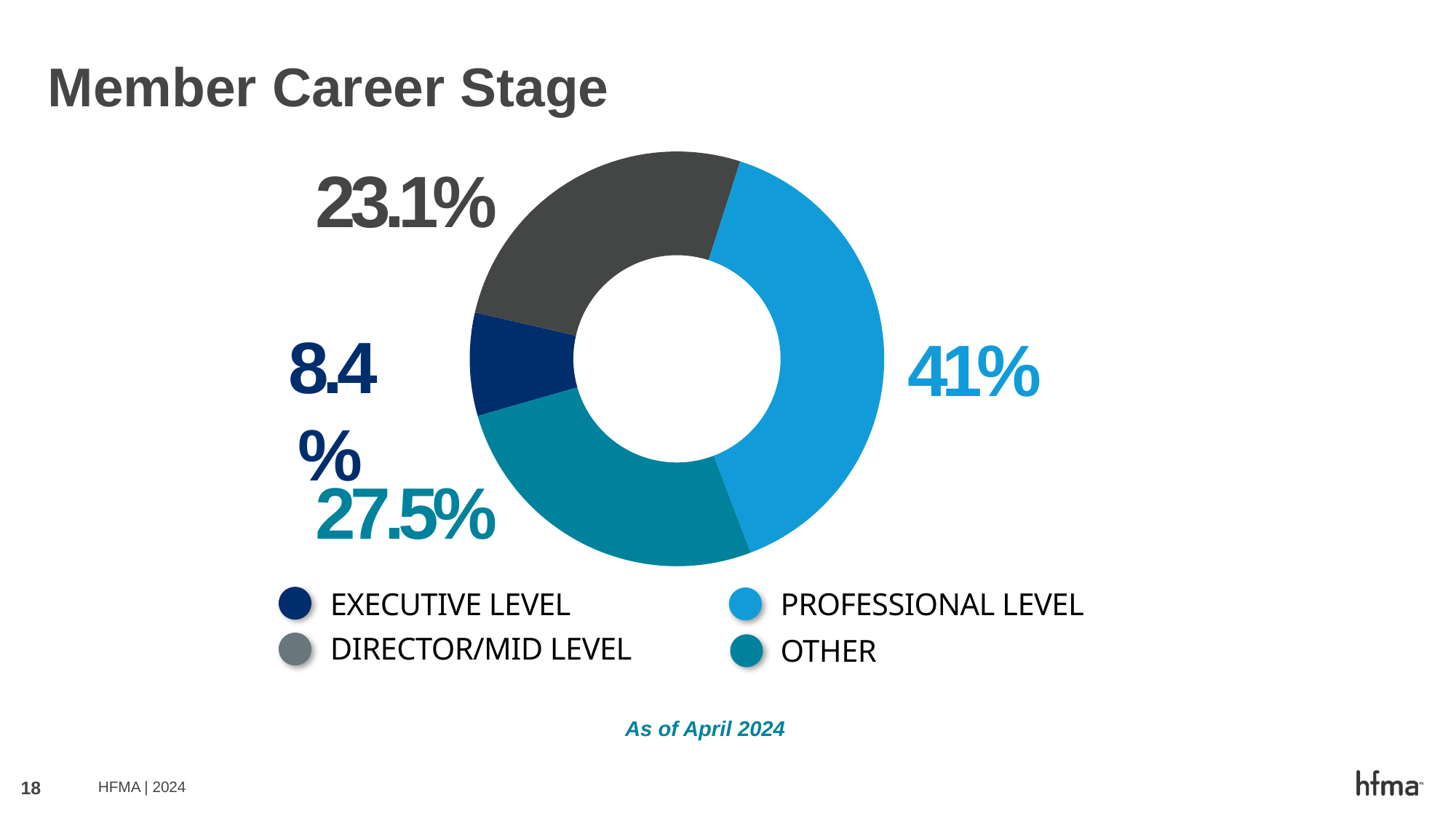
What percentage of members are at the Director/Mid Level? 23.1% As of what date is the chart data reported? April 2024 Which career stage has the largest share of members? Professional Level What kind of chart is used on this slide? Pie chart (donut) What percentage of members fall into the Other category? 27.5% Which is larger, the Other share or the Director/Mid Level share? Other What is the title of the chart on this slide? Member Career Stage How many career stage categories are shown in the chart? 4 What is the difference in percentage points between the Professional Level and Director/Mid Level shares? 17.9 Which career stage has the smallest share of members? Executive Level What percentage of members are at the Executive Level? 8.4% What percentage of members are at the Professional Level? 41%